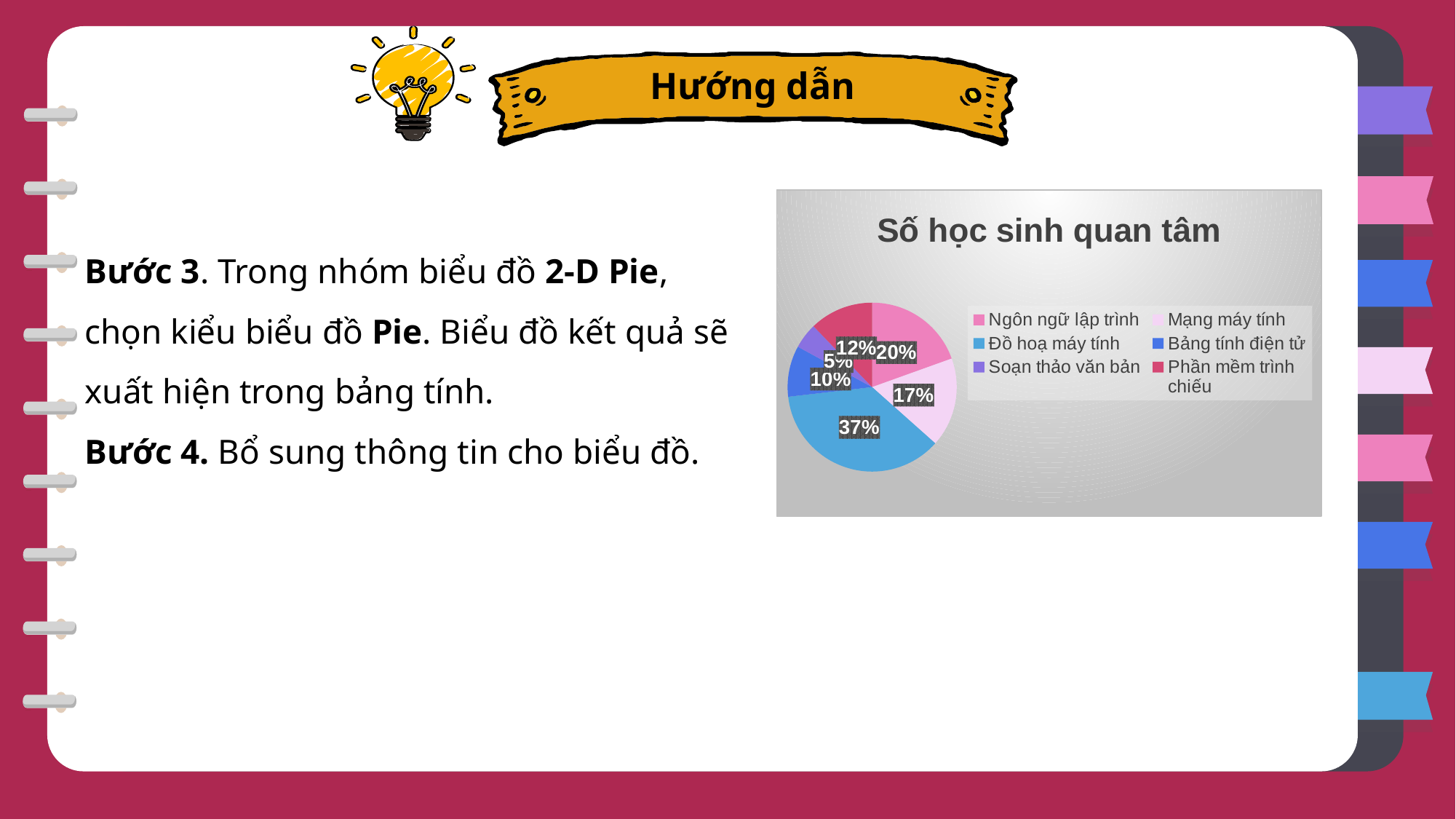
Which slice is larger, Bảng tính điện tử or Phần mềm trình chiếu? Phần mềm trình chiếu What colour is the slice for Đồ hoạ máy tính? Blue What share of the pie does Soạn thảo văn bản take? 5% How many categories does the legend of the chart list? 6 What is the title of the chart? Số học sinh quan tâm What share of the pie does Mạng máy tính take? 17% Which category has the smallest slice of the pie? Soạn thảo văn bản What share of the pie does Ngôn ngữ lập trình take? 20% What kind of chart is shown on the slide? Pie chart Which category has the largest slice of the pie? Đồ hoạ máy tính What is the difference in percentage points between Đồ hoạ máy tính and Ngôn ngữ lập trình? 17